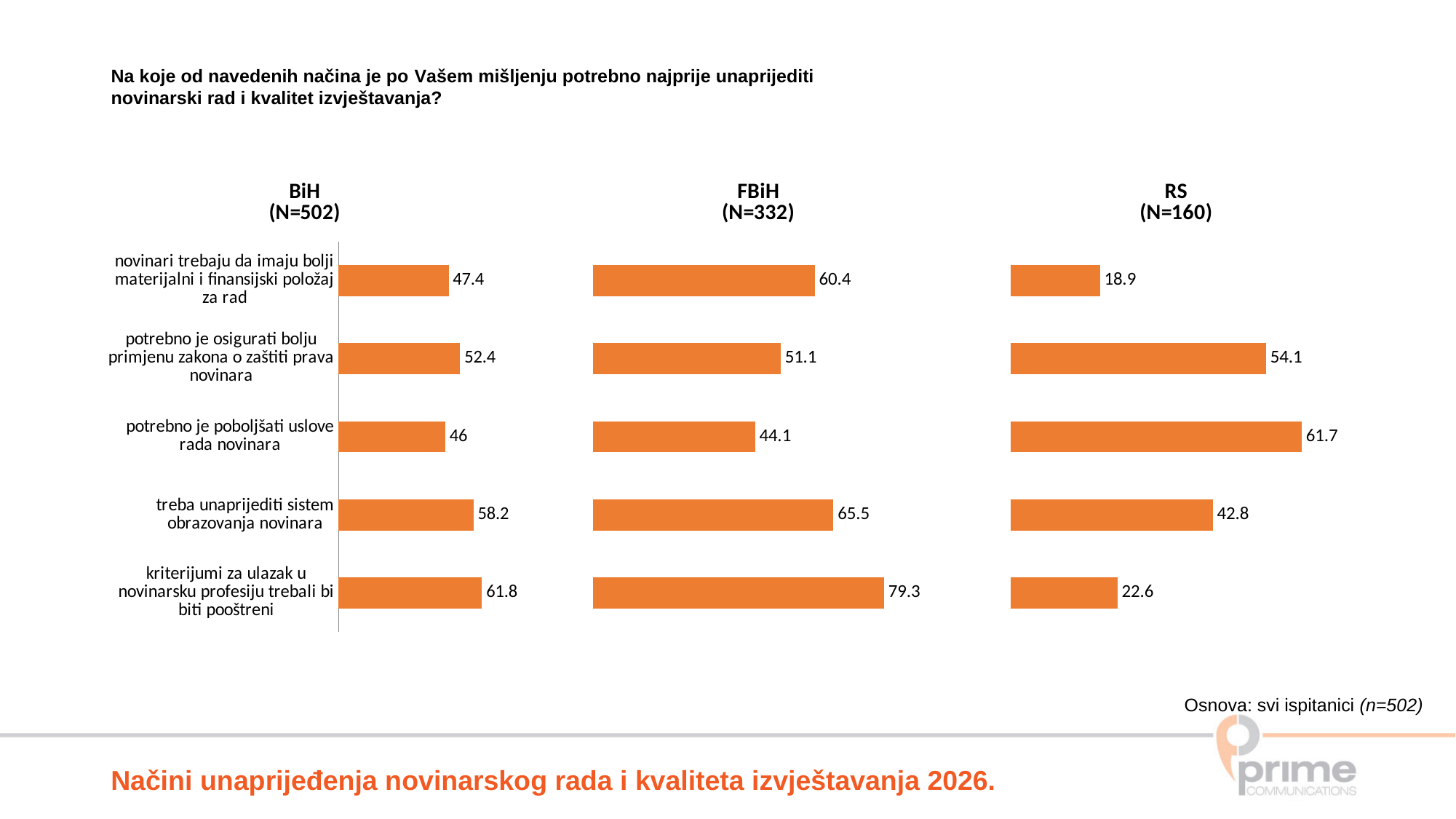
In the BiH (N=502) chart, what is the value for "kriterijumi za ulazak u novinarsku profesiju trebali bi biti pooštreni"? 61.8 In the FBiH (N=332) chart, what is the difference between the values for "kriterijumi za ulazak u novinarsku profesiju trebali bi biti pooštreni" and "treba unaprijediti sistem obrazovanja novinara"? 13.8 In the FBiH (N=332) chart, what is the value for "potrebno je poboljšati uslove rada novinara"? 44.1 Which is larger: the value for "potrebno je osigurati bolju primjenu zakona o zaštiti prava novinara" in the BiH (N=502) chart or in the RS (N=160) chart? RS (N=160) In the RS (N=160) chart, what is the difference between the values for "potrebno je poboljšati uslove rada novinara" and "treba unaprijediti sistem obrazovanja novinara"? 18.9 In the FBiH (N=332) chart, which category has the highest value? kriterijumi za ulazak u novinarsku profesiju trebali bi biti pooštreni In the BiH (N=502) chart, which category has the lowest value? potrebno je poboljšati uslove rada novinara How many separate charts are shown on the slide? 3 In the RS (N=160) chart, which category has the lowest value? novinari trebaju da imaju bolji materijalni i finansijski položaj za rad In the RS (N=160) chart, what is the value for "novinari trebaju da imaju bolji materijalni i finansijski položaj za rad"? 18.9 What type of chart is the FBiH (N=332) chart? Bar chart How many categories are shown in the BiH (N=502) chart? 5